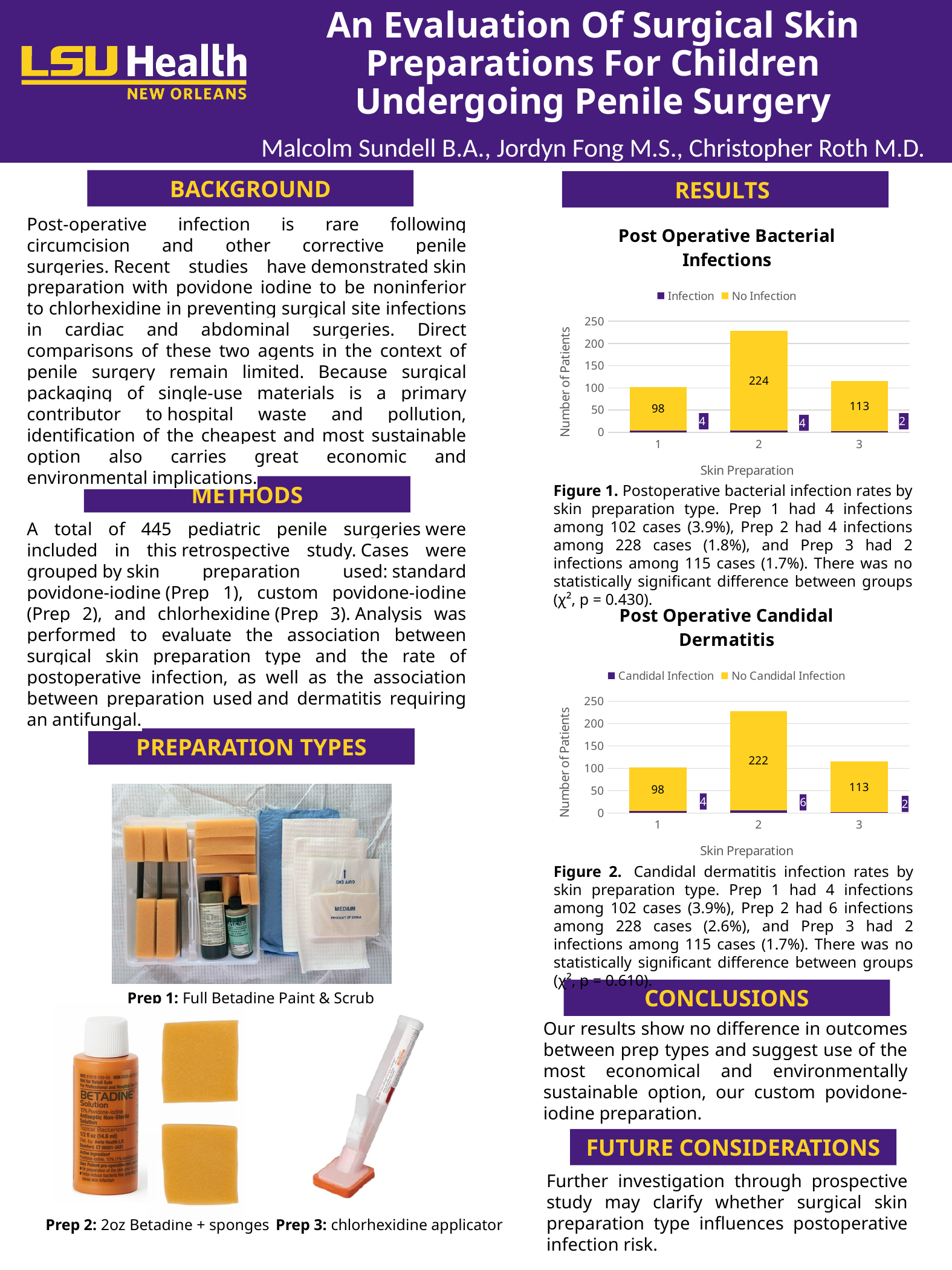
In the Post Operative Candidal Dermatitis chart, what is the total number of patients for skin preparation 2 (Candidal Infection plus No Candidal Infection)? 228 In the Post Operative Candidal Dermatitis chart, what is the No Candidal Infection value for skin preparation 3? 113 What type of chart is the Post Operative Candidal Dermatitis chart? Stacked bar chart In the Post Operative Bacterial Infections chart, what is the difference between the No Infection values for skin preparations 2 and 3? 111 In the Post Operative Bacterial Infections chart, which skin preparation has the highest No Infection value? 2 How many skin preparation categories are shown on the x axis of the Post Operative Candidal Dermatitis chart? 3 In the Post Operative Bacterial Infections chart, how many patients in skin preparation 3 had an infection? 2 How many series does the legend of the Post Operative Bacterial Infections chart list? 2 In the Post Operative Candidal Dermatitis chart, what is the Candidal Infection value for skin preparation 2? 6 In the Post Operative Candidal Dermatitis chart, which skin preparation has the lowest Candidal Infection value? 3 In the Post Operative Bacterial Infections chart, what is the total number of patients for skin preparation 1 (Infection plus No Infection)? 102 In the Post Operative Bacterial Infections chart, what is the No Infection value for skin preparation 2? 224